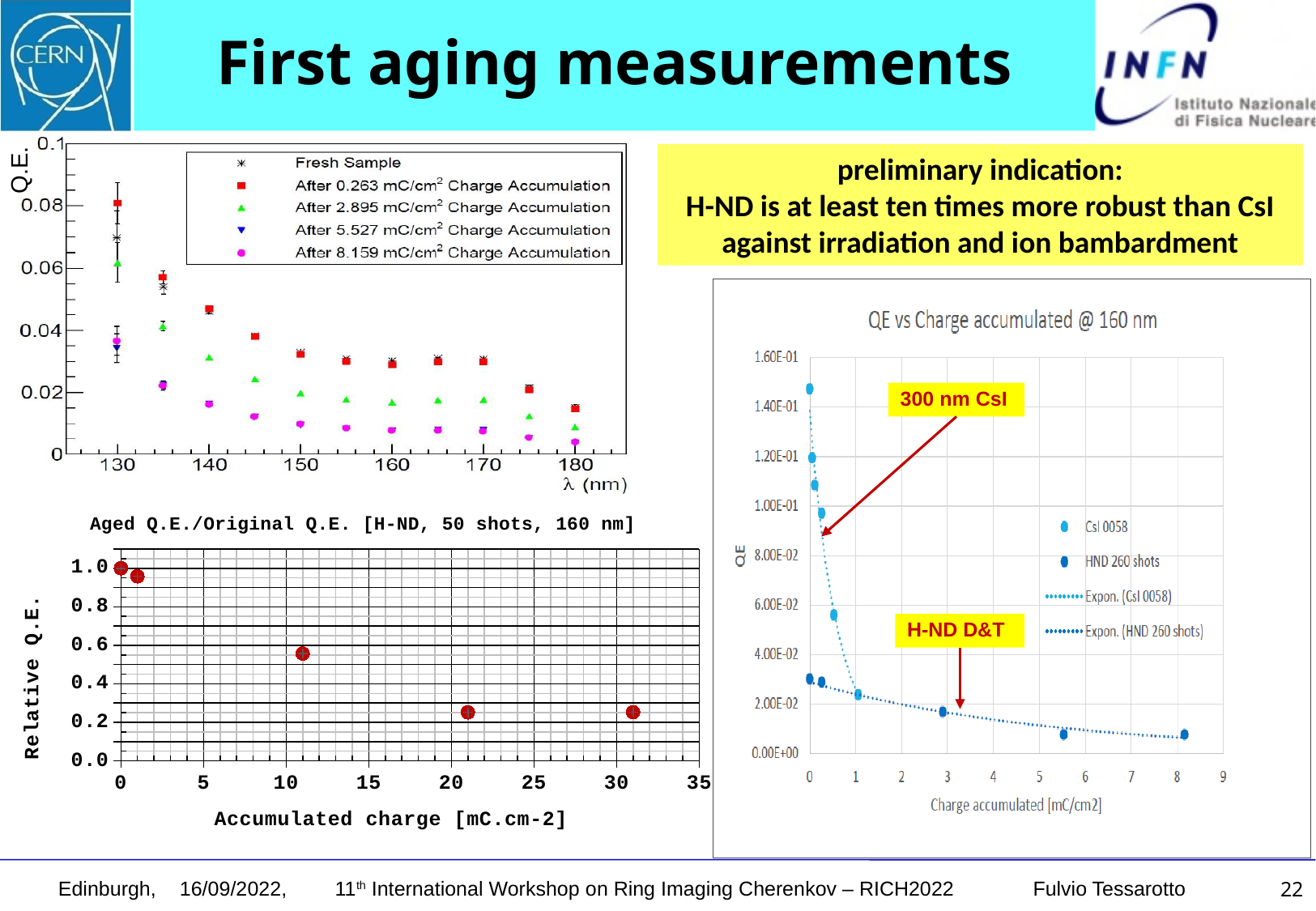
On the bottom-left chart 'Aged Q.E./Original Q.E.', does the relative Q.E. rise or fall as the accumulated charge increases? fall On the top-left chart (Q.E. versus wavelength), what kind of chart is it? scatter plot On the top-left chart (Q.E. versus wavelength), do the Q.E. values generally rise or fall as the wavelength increases from 130 nm to 180 nm? fall On the bottom-left chart 'Aged Q.E./Original Q.E.', is the relative Q.E. at about 21 mC.cm-2 greater or less than 0.4? less On the right chart 'QE vs Charge accumulated @ 160 nm', how many entries does the legend list? 4 On the right chart 'QE vs Charge accumulated @ 160 nm', is the QE of HND 260 shots at zero accumulated charge greater or less than 4.00E-02? less On the top-left chart (Q.E. versus wavelength), is the Q.E. of the 'After 8.159 mC/cm2 Charge Accumulation' series at 130 nm greater or less than 0.04? less On the bottom-left chart 'Aged Q.E./Original Q.E.', what is the label of the x axis? Accumulated charge [mC.cm-2] On the right chart 'QE vs Charge accumulated @ 160 nm', which series has the higher QE at zero accumulated charge, CsI 0058 or HND 260 shots? CsI 0058 On the bottom-left chart 'Aged Q.E./Original Q.E.', how many data points are plotted? 5 On the top-left chart (Q.E. versus wavelength), how many series does the legend list? 5